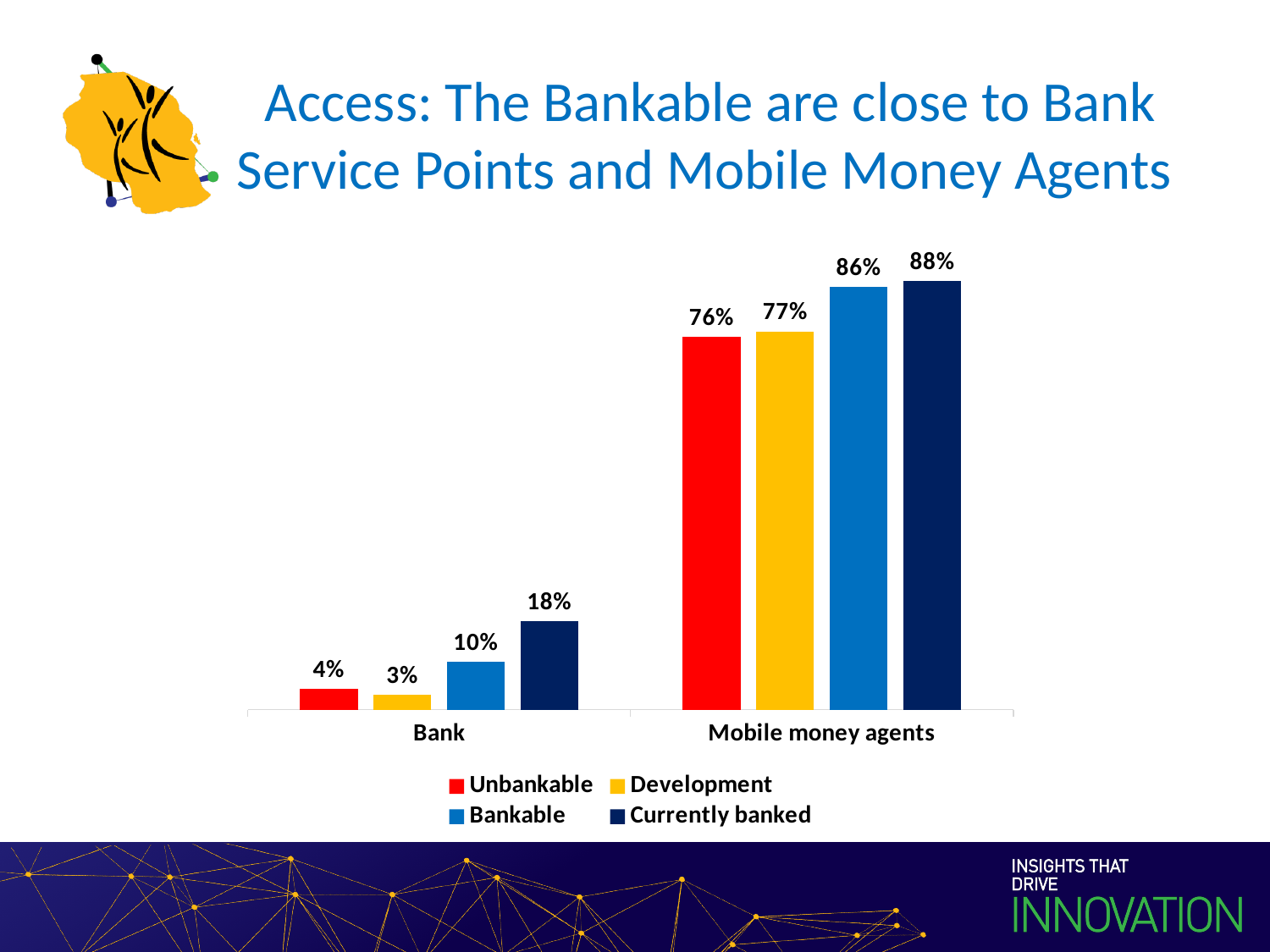
What is the difference between the Currently banked value for Mobile money agents and for Bank? 70% How many series does the legend list? 4 What is the difference between the Currently banked and Bankable values in the Bank category? 8% What is the value for Development in the Bank category? 3% What kind of chart is shown on the slide? Bar chart What is the value for Bankable in the Mobile money agents category? 86% What is the value for Currently banked in the Bank category? 18% What is the value for Unbankable in the Mobile money agents category? 76% Which series has the highest value in the Mobile money agents category? Currently banked How many categories are shown on the x axis? 2 Which series has the lowest value in the Bank category? Development Which is larger: the Unbankable value for Bank or the Bankable value for Bank? Bankable